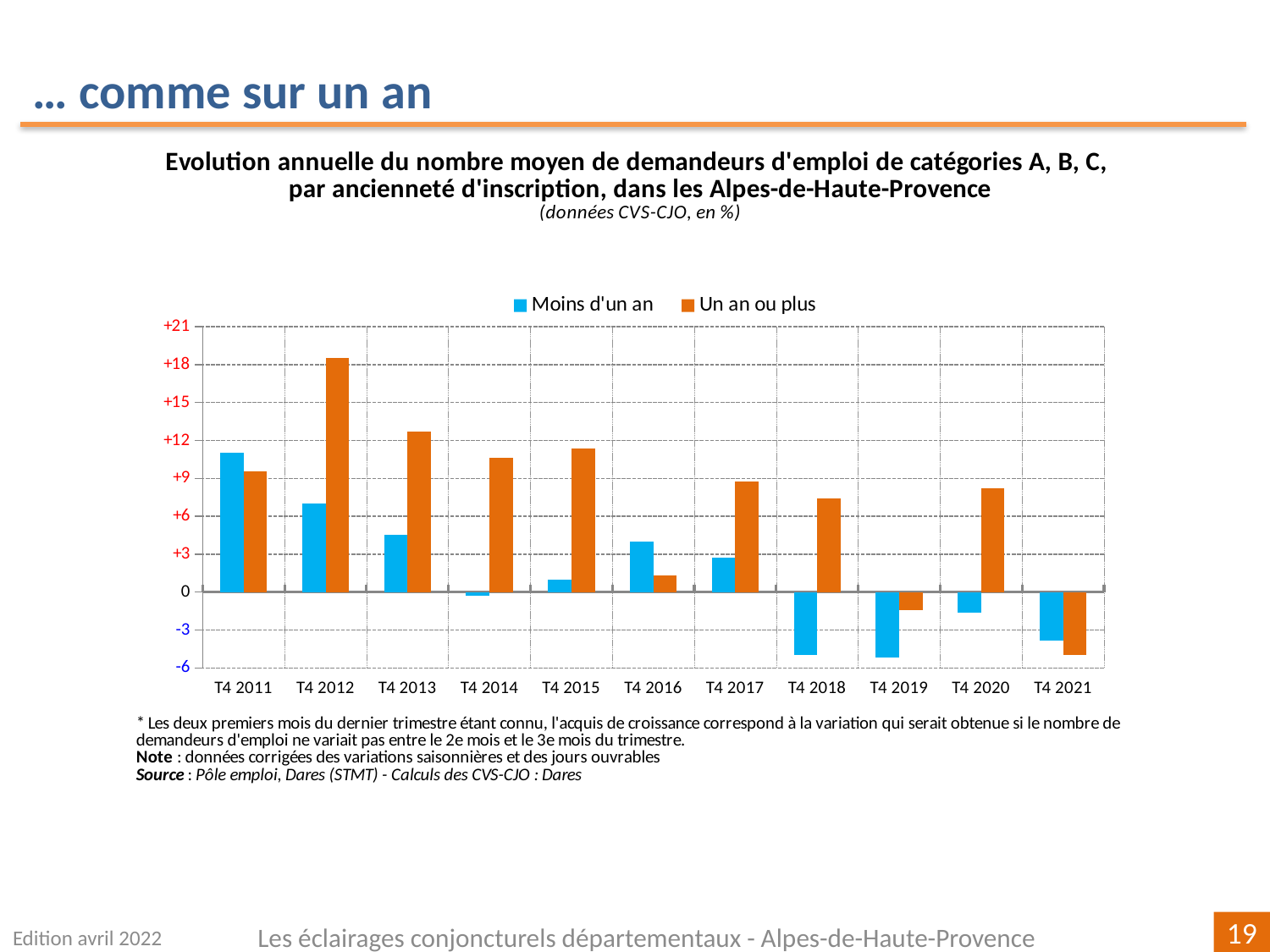
In T4 2013, which series has the larger value, 'Moins d'un an' or 'Un an ou plus'? Un an ou plus Is the 'Moins d'un an' value for T4 2018 greater or less than -3? less For which quarter is the 'Moins d'un an' value the highest? T4 2011 Is the 'Moins d'un an' value for T4 2011 greater or less than +9? greater How many series does the legend list? 2 For which quarter is the 'Un an ou plus' value the highest? T4 2012 How many quarters (categories) are shown on the x axis? 11 For which quarter is the 'Un an ou plus' value the lowest? T4 2021 What kind of chart is shown on the slide? bar chart Is the 'Un an ou plus' value for T4 2012 greater or less than +15? greater In T4 2016, which series has the larger value, 'Moins d'un an' or 'Un an ou plus'? Moins d'un an What are the two series named in the legend? Moins d'un an; Un an ou plus